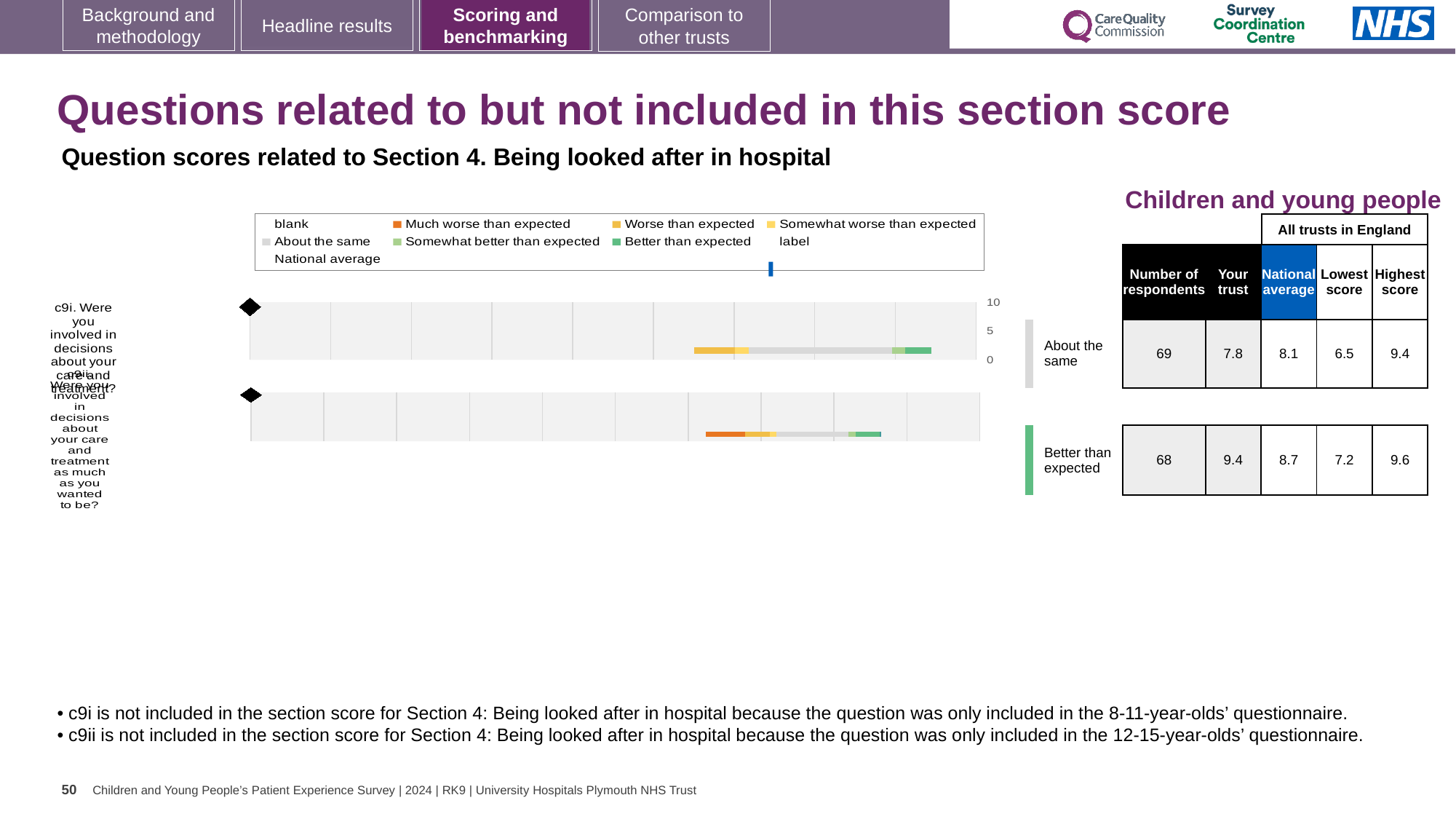
What is the difference between the 'Your trust' score and the national average for c9ii? 0.7 What is the 'Your trust' score for c9i (About the same)? 7.8 Which question has the higher 'Your trust' score, c9i or c9ii? c9ii What is the highest score across all trusts in England for c9i? 9.4 What kind of chart is shown on the slide? Bar chart How many respondents answered c9ii? 68 How many entries does the chart legend list? 9 What is the 'Your trust' score for c9ii (Better than expected)? 9.4 How many questions (bars) are plotted in the chart? 2 What is the national average for c9i? 8.1 What is the national average for c9ii? 8.7 What benchmark category is shown for c9i? About the same